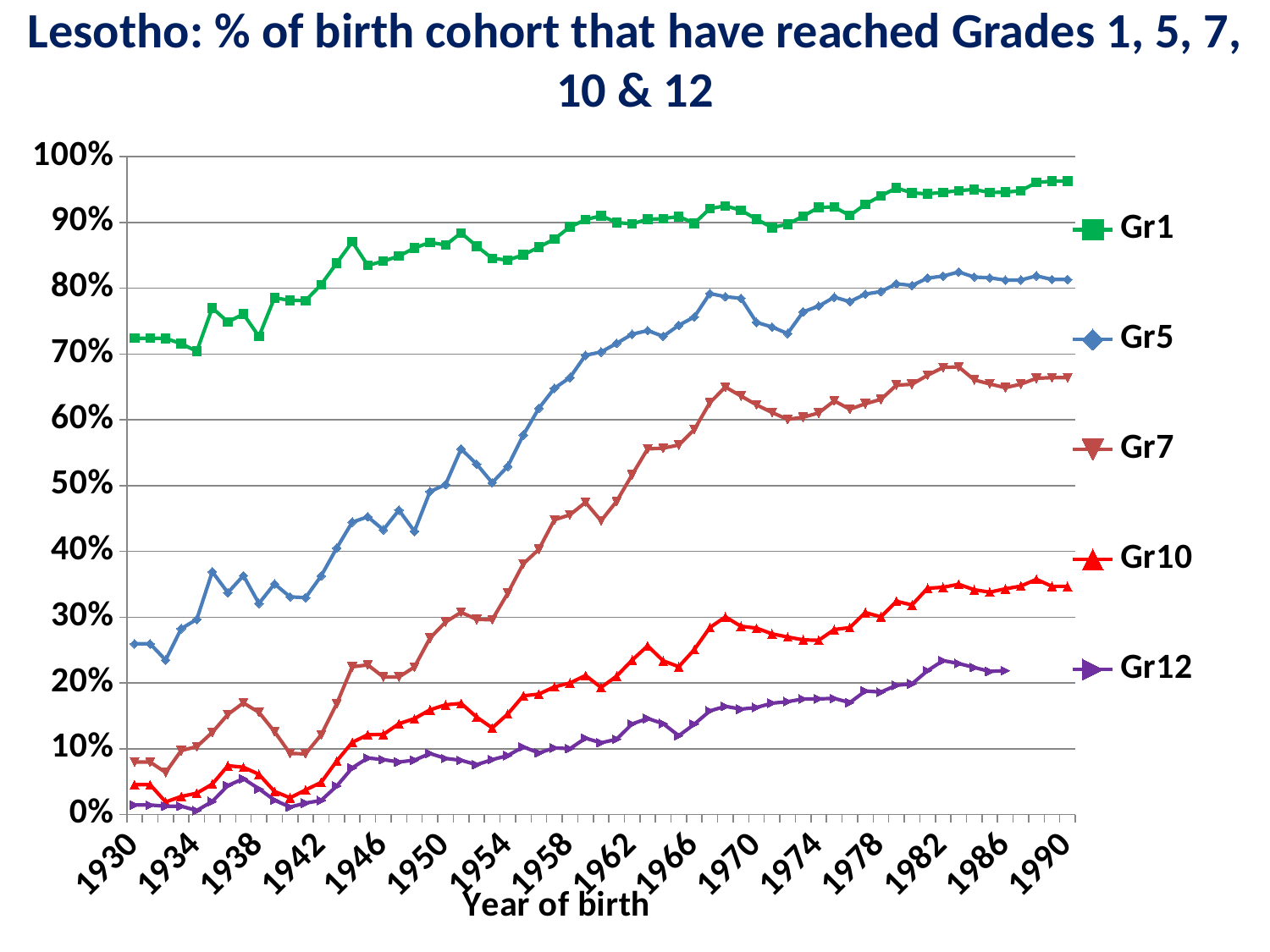
What kind of chart is shown on the slide? line chart Is the Gr5 value for 1930 greater or less than 30%? less Is the Gr7 value for 1990 greater or less than 60%? greater How many series does the legend list? 5 Is the Gr12 value for 1930 greater or less than 10%? less Which series has the highest values across the chart? Gr1 Do the Gr5 values generally rise or fall from 1930 to 1990? rise Which colour is used for the Gr1 series? green Which is larger in 1986, the Gr10 value or the Gr12 value? Gr10 What is the label of the x axis? Year of birth Which series has the lowest values across the chart? Gr12